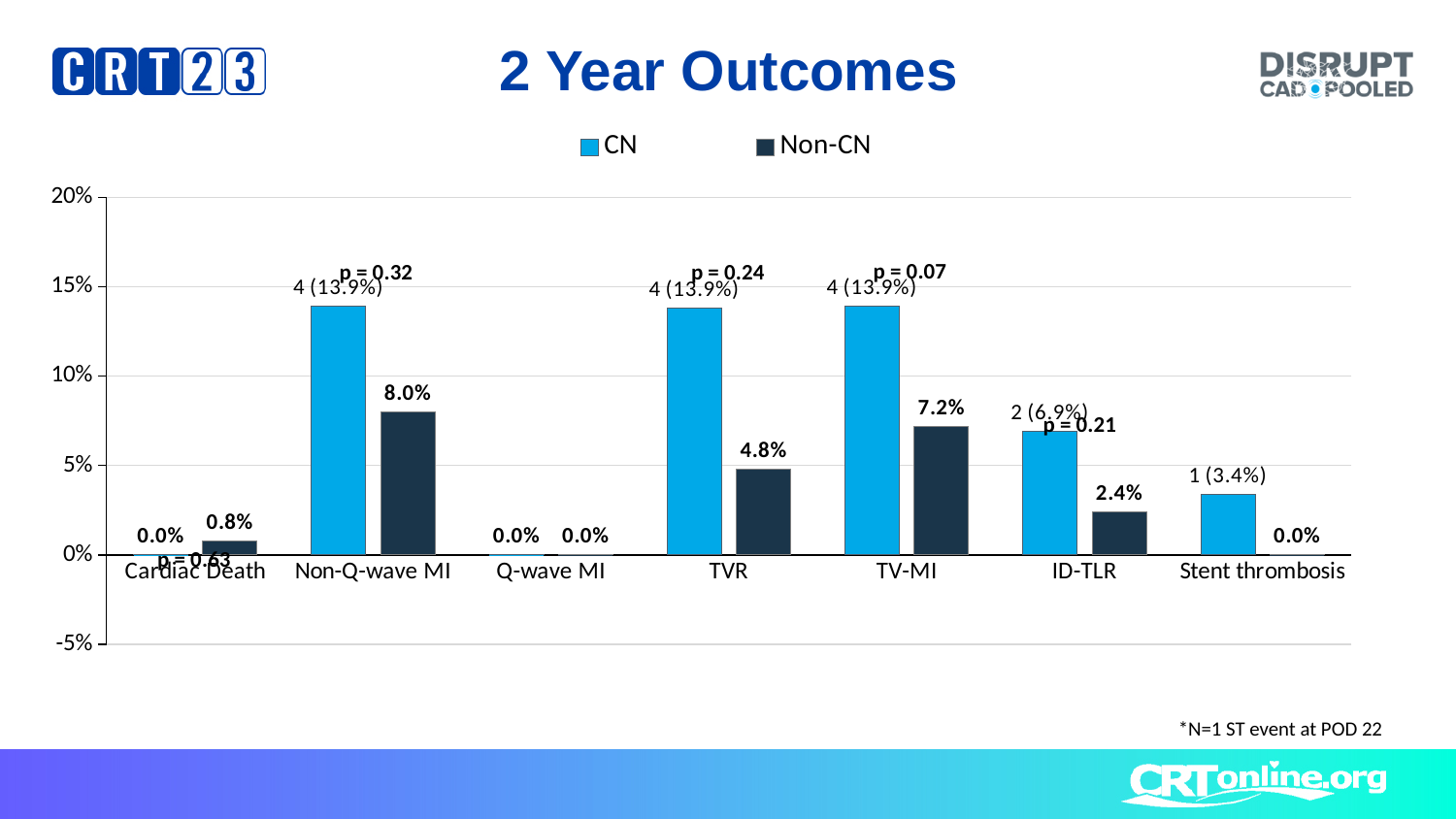
Which category has the highest Non-CN value? Non-Q-wave MI Is the Non-CN value for TV-MI greater or less than 5%? greater What is the CN data label for Stent thrombosis? 1 (3.4%) What is the Non-CN value for Non-Q-wave MI? 8.0% What p-value is shown above the TV-MI bars? p = 0.07 What kind of chart is shown on the slide? bar chart Which is larger for TV-MI, the CN value or the Non-CN value? CN What is the Non-CN value for ID-TLR? 2.4% How many outcome categories are shown on the x axis? 7 How many series does the legend list? 2 What is the CN data label for TVR? 4 (13.9%) What is the difference between the Non-CN values for Non-Q-wave MI and TVR? 3.2%